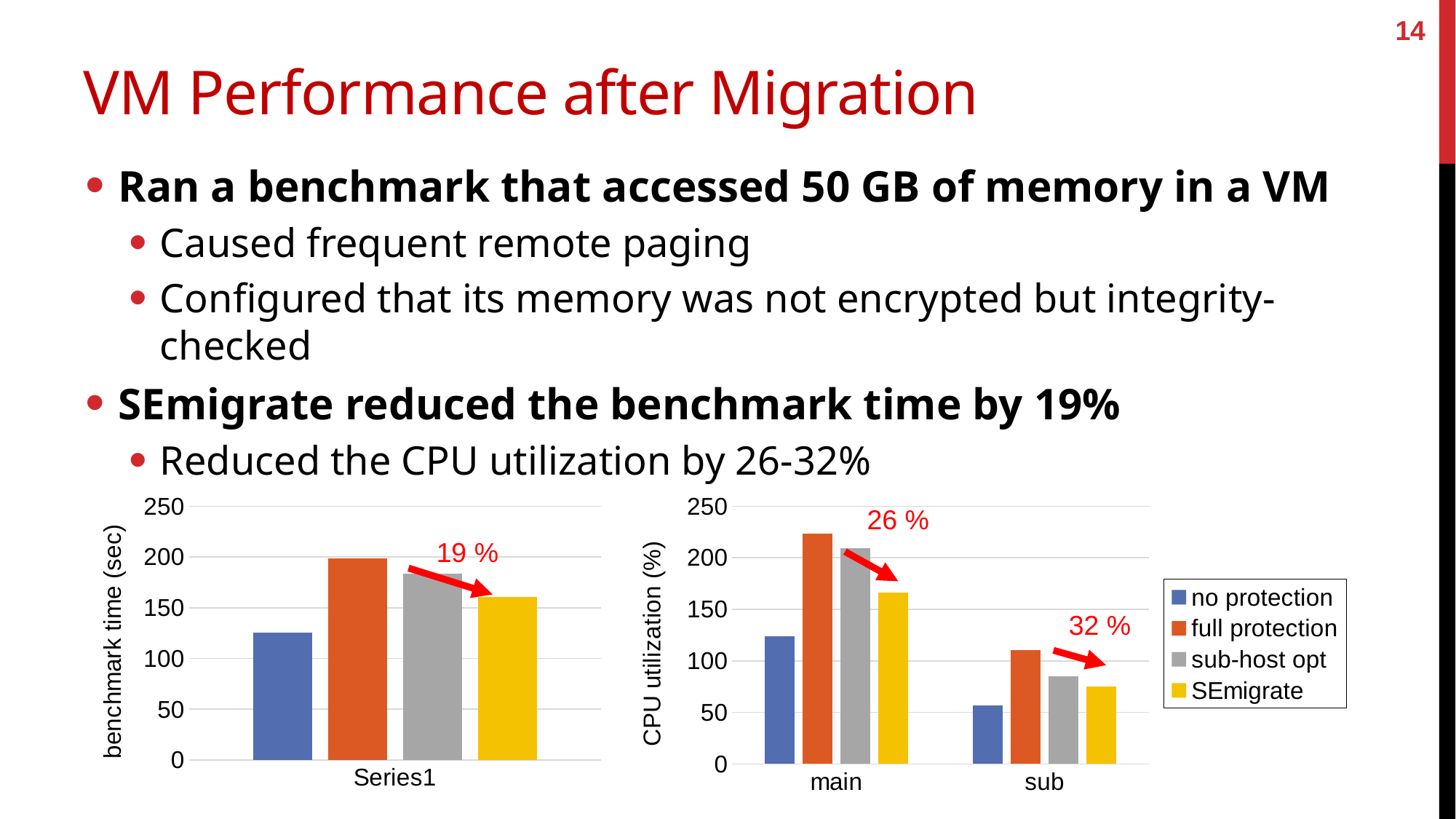
In the right chart (CPU utilization), which series has the highest bar for the main category? full protection What percentage reduction is annotated on the left chart (benchmark time)? 19 % In the right chart (CPU utilization), which series has the lowest bar for the sub category? no protection In the right chart (CPU utilization), is the value for SEmigrate in the sub category greater or less than 100? less In the right chart (CPU utilization), which is larger for the sub category: sub-host opt or SEmigrate? sub-host opt What kind of chart is the left chart (benchmark time)? bar chart In the left chart (benchmark time), which series has the highest bar? full protection How many series does the legend list? 4 In the left chart (benchmark time), is the value for SEmigrate greater or less than 150? greater In the right chart (CPU utilization), how many categories are shown on the x axis? 2 In the right chart (CPU utilization), is the value for full protection in the main category greater or less than 200? greater In the left chart (benchmark time), which series has the lowest bar? no protection